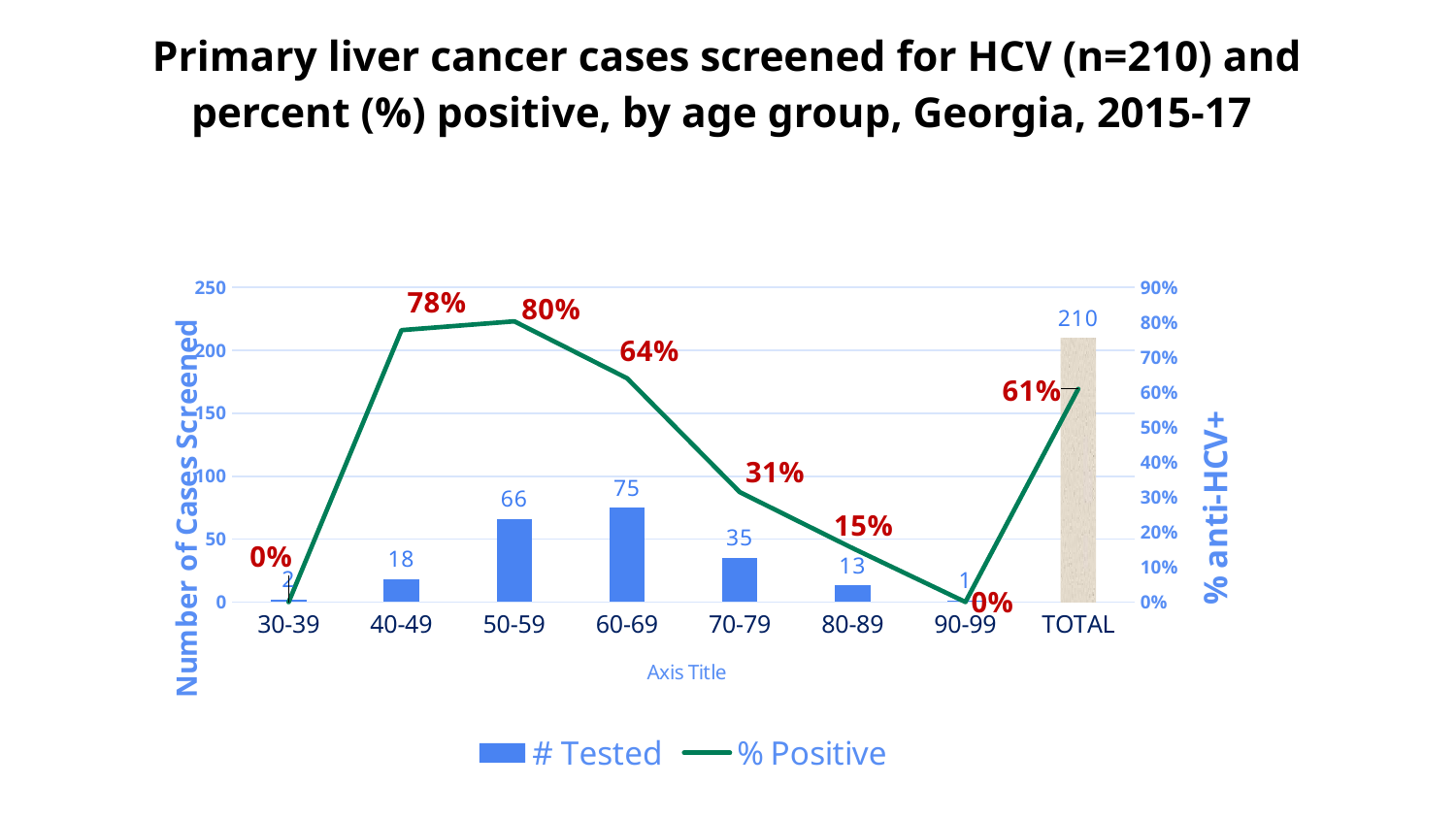
What is the % Positive value for the TOTAL category? 61% What is the difference in number tested between the 60-69 and 50-59 age groups? 9 Which has more cases tested, the 70-79 age group or the 40-49 age group? 70-79 What is the label of the right-hand vertical axis? % anti-HCV+ What is the difference in % Positive between the 40-49 and 70-79 age groups? 47% Which age group has the lowest number tested? 90-99 How many series does the legend list? 2 Which age group has the highest % Positive value? 50-59 How many cases were tested in the 80-89 age group? 13 What is the % Positive value for the 50-59 age group? 80% How many cases were tested in the 60-69 age group? 75 Excluding the TOTAL bar, which age group has the highest number tested? 60-69